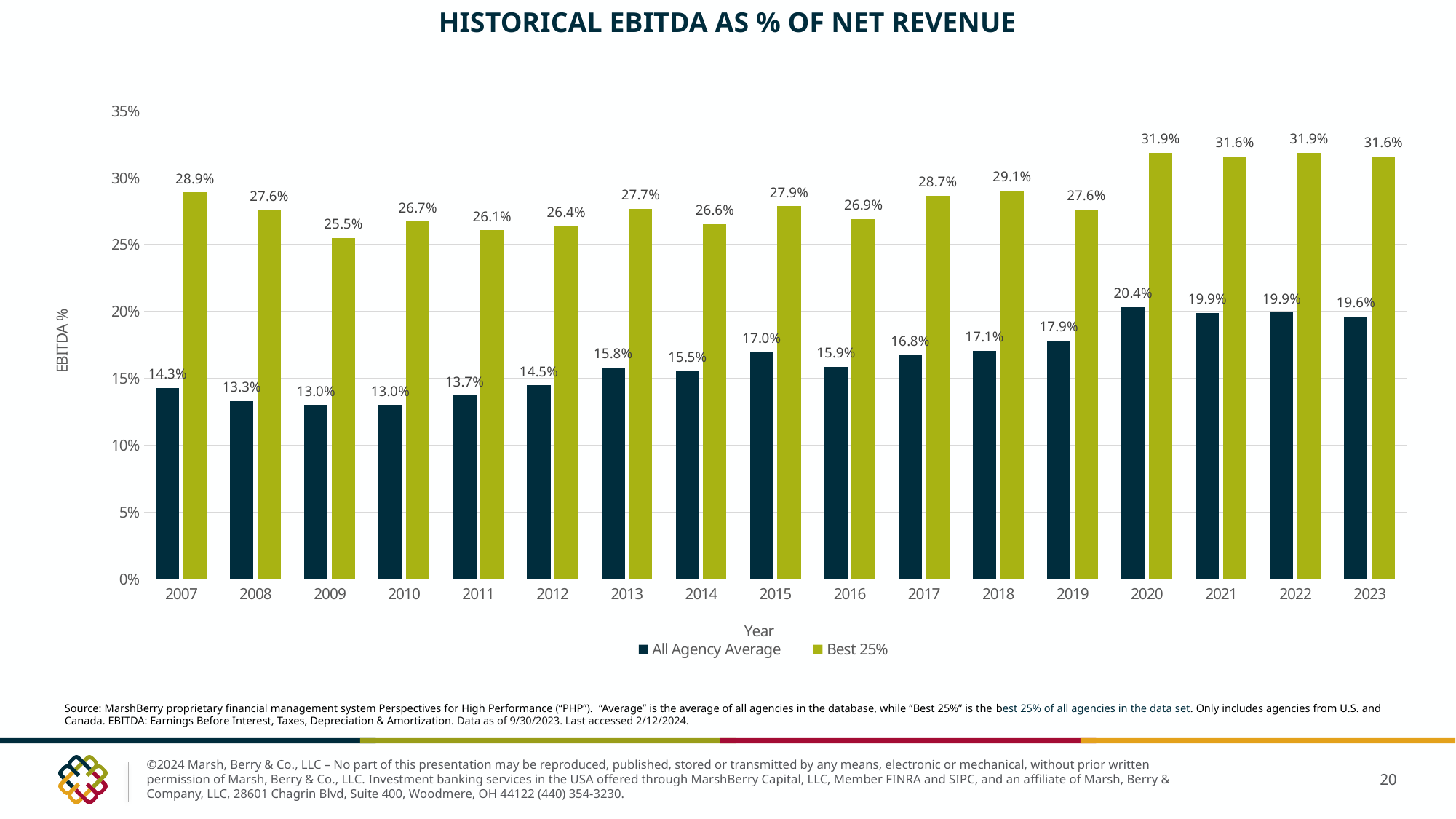
What is the All Agency Average value for 2013? 15.8% How many series does the legend list? 2 What is the Best 25% value for 2018? 29.1% What kind of chart is shown on the slide? Bar chart Is the Best 25% value for 2021 greater or less than 30%? greater In which year is the All Agency Average at its highest? 2020 Which is larger: the All Agency Average in 2019 or in 2016? 2019 In which year is the Best 25% value at its lowest? 2009 How many years are shown on the x axis? 17 What is the title of the chart? HISTORICAL EBITDA AS % OF NET REVENUE What is the All Agency Average EBITDA as % of net revenue for 2020? 20.4% What is the difference between the Best 25% and All Agency Average values in 2023? 12.0 percentage points